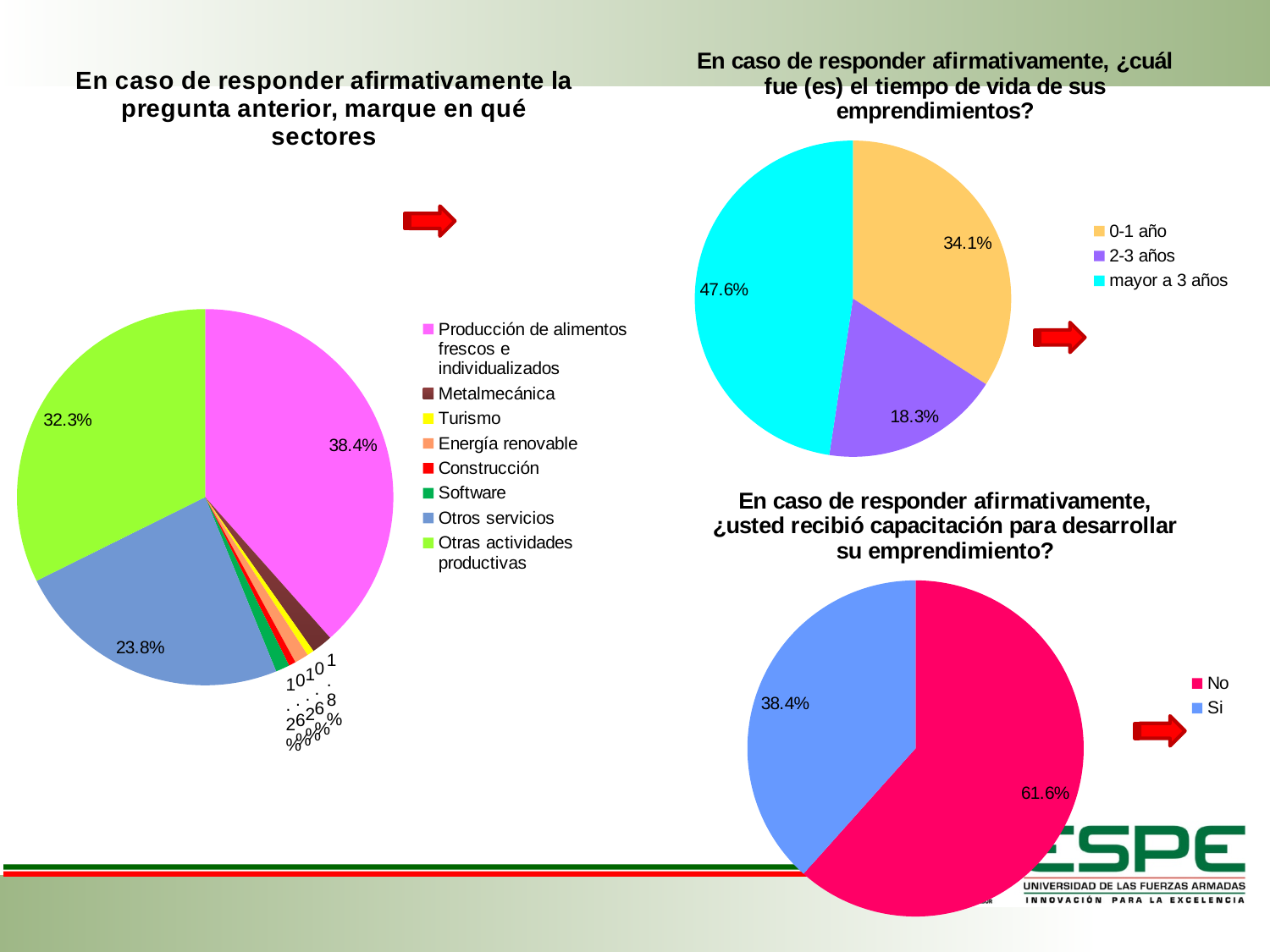
In the pie chart about sectors, what share is labelled for 'Otros servicios'? 23.8% In the pie chart about the lifetime of the ventures, which category has the largest share? mayor a 3 años In the pie chart about whether respondents received training, which answer is larger, 'No' or 'Si'? No In the pie chart about whether respondents received training (capacitación), what share answered 'No'? 61.6% In the pie chart about the lifetime of the ventures, what share is labelled for '0-1 año'? 34.1% In the pie chart about the lifetime of the ventures (tiempo de vida de sus emprendimientos), what share is labelled for 'mayor a 3 años'? 47.6% How many entries does the legend of the pie chart about sectors list? 8 In the pie chart about whether respondents received training (capacitación), what share answered 'Si'? 38.4% In the pie chart about the lifetime of the ventures, what share is labelled for '2-3 años'? 18.3% In the pie chart about sectors (marque en qué sectores), what share is labelled for 'Producción de alimentos frescos e individualizados'? 38.4% In the pie chart about the lifetime of the ventures, which category has the smallest share? 2-3 años In the pie chart about the lifetime of the ventures, what is the difference between the shares for 'mayor a 3 años' and '0-1 año'? 13.5%